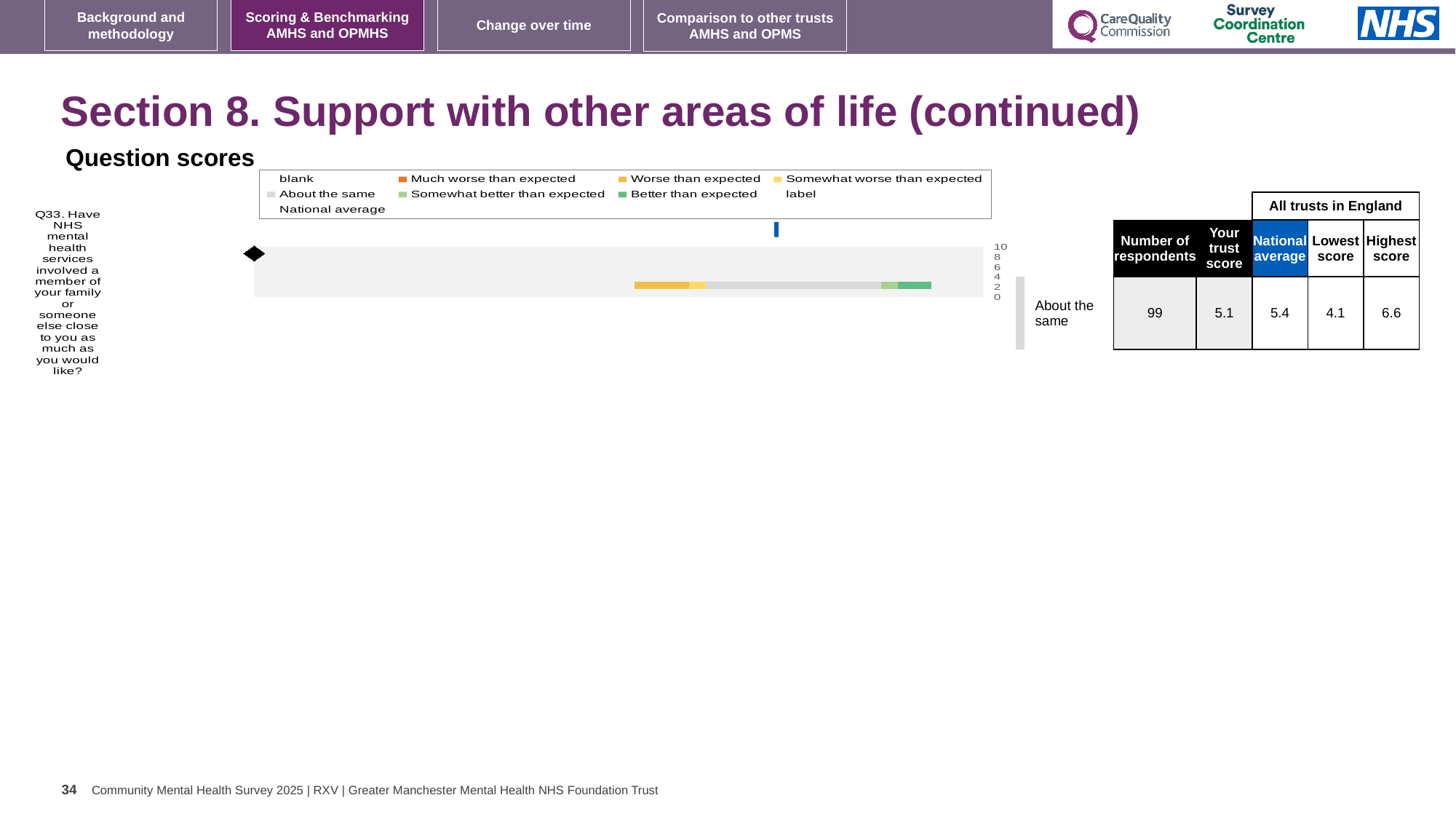
What benchmark label is shown to the right of the bar for Q33? About the same Which question is plotted in the chart? Q33. Have NHS mental health services involved a member of your family or someone else close to you as much as you would like? Which is larger for Q33, the trust score or the national average? national average What colour does the legend use for 'Much worse than expected'? orange How many questions (categories) are plotted in the chart? 1 In the table next to the chart, what is the national average for Q33? 5.4 In the table next to the chart, what is the lowest score among all trusts in England for Q33? 4.1 In the table next to the chart, what is 'Your trust score' for Q33? 5.1 In the table next to the chart, what is the highest score among all trusts in England for Q33? 6.6 In the table next to the chart, what is the number of respondents for Q33? 99 What kind of chart is shown on the slide? bar chart How many entries does the chart's legend list? 9